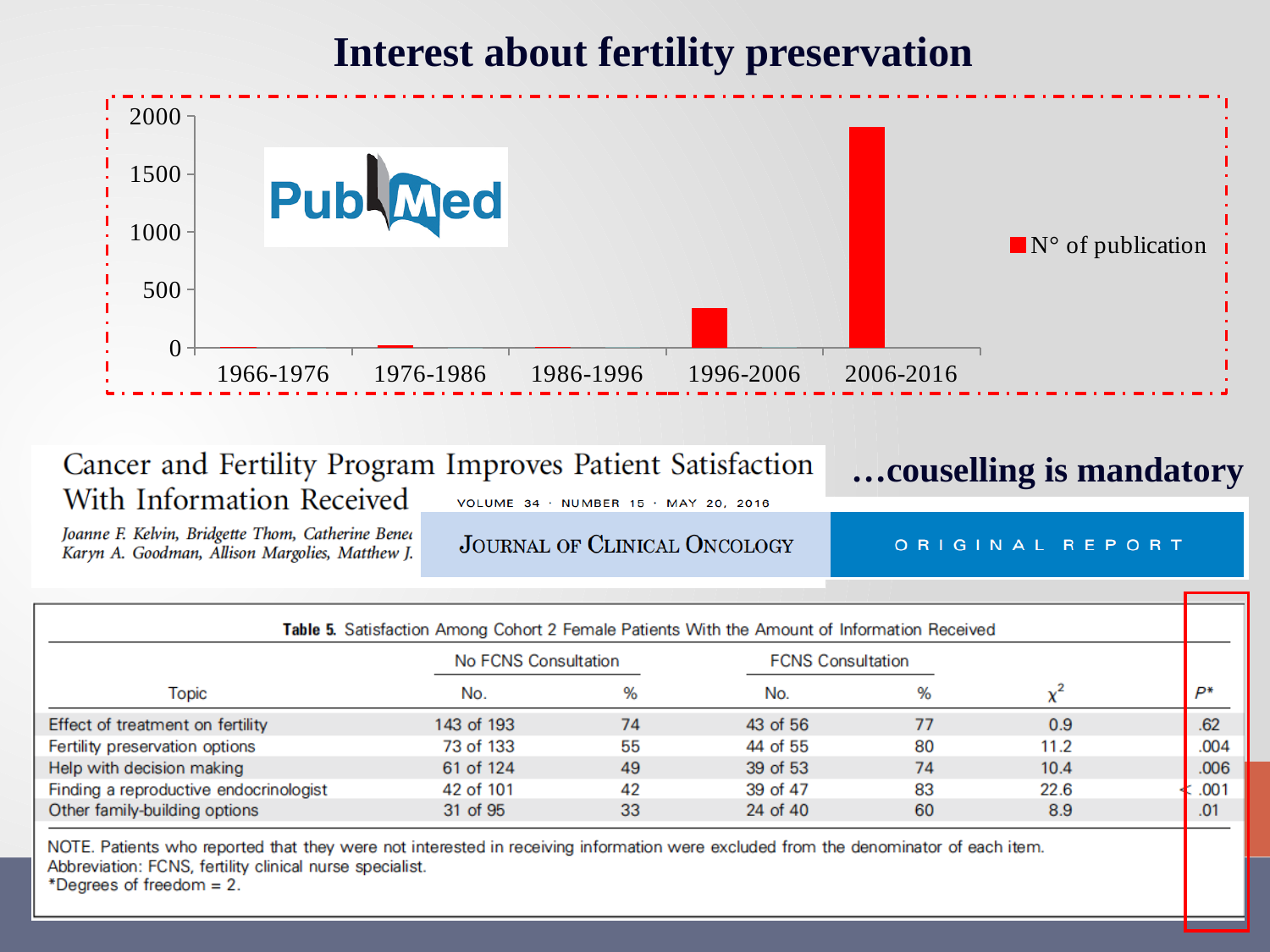
Which time period has the highest number of publications in the chart? 2006-2016 Which has the larger value in the chart, 1986-1996 or 1996-2006? 1996-2006 Do the values in the chart generally rise or fall from 1966-1976 to 2006-2016? rise What kind of chart is shown on the slide? bar chart What is the series name shown in the chart legend? N° of publication Is the value for 1976-1986 greater or less than 500? less Is the value for 1996-2006 greater or less than 500? less What is the title above the chart on the slide? Interest about fertility preservation How many time-period categories are shown on the x axis of the chart? 5 Which has the larger value in the chart, 1996-2006 or 2006-2016? 2006-2016 Is the value for 2006-2016 greater or less than 1500? greater How many series does the chart legend list? 1